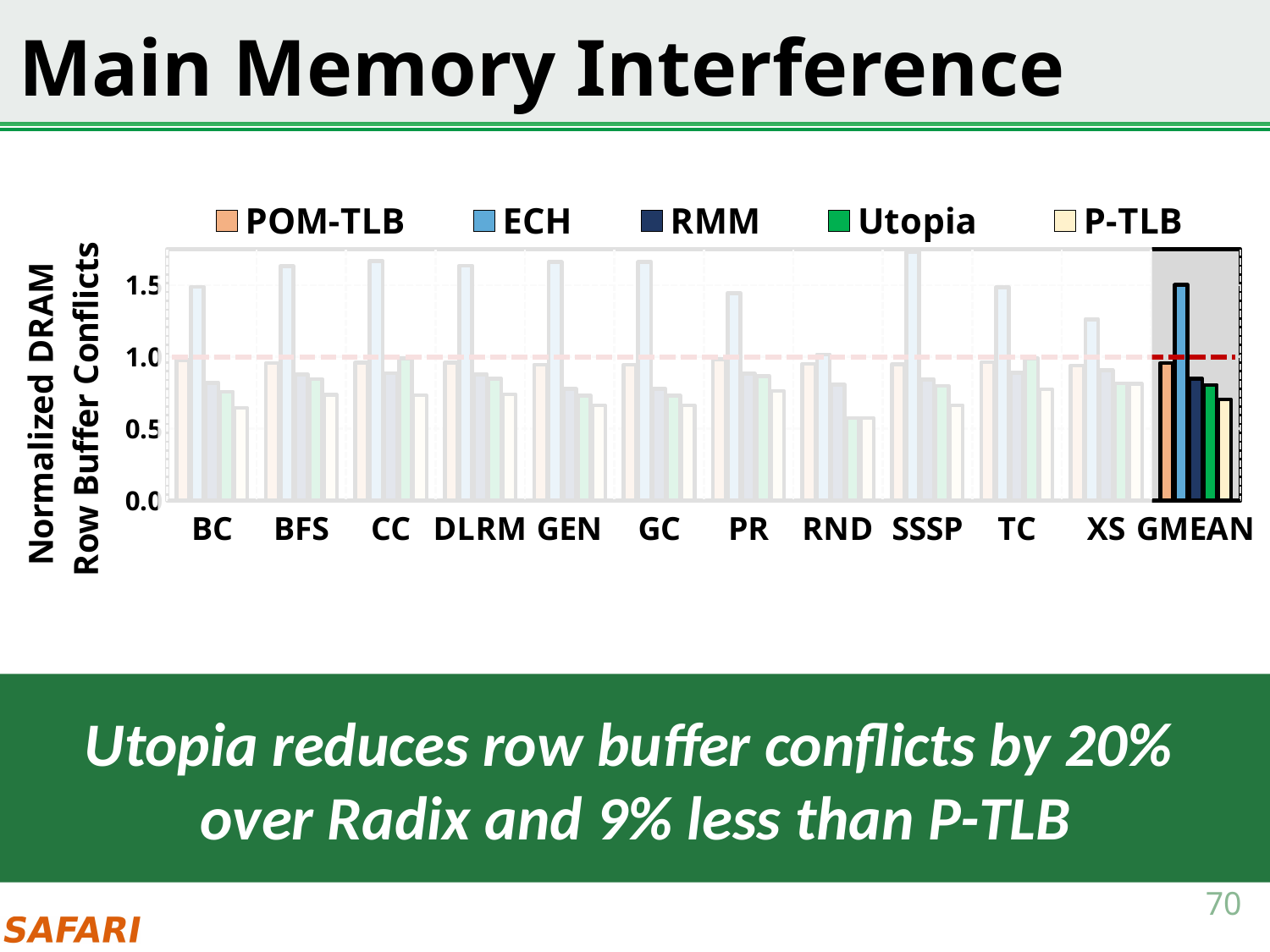
Is the ECH value for SSSP greater or less than 1.5? greater How many categories are shown along the x axis? 12 What is the label of the y axis? Normalized DRAM Row Buffer Conflicts Which category on the x axis is highlighted with a shaded background? GMEAN What kind of chart is shown on the slide? bar chart Is the Utopia value for GMEAN greater or less than 1.0? less Is the ECH value for GMEAN greater or less than 1.0? greater For BC, which is larger: the ECH value or the Utopia value? ECH Which series has the highest value for GMEAN? ECH Which series has the lowest value for GMEAN? P-TLB How many series does the legend list? 5